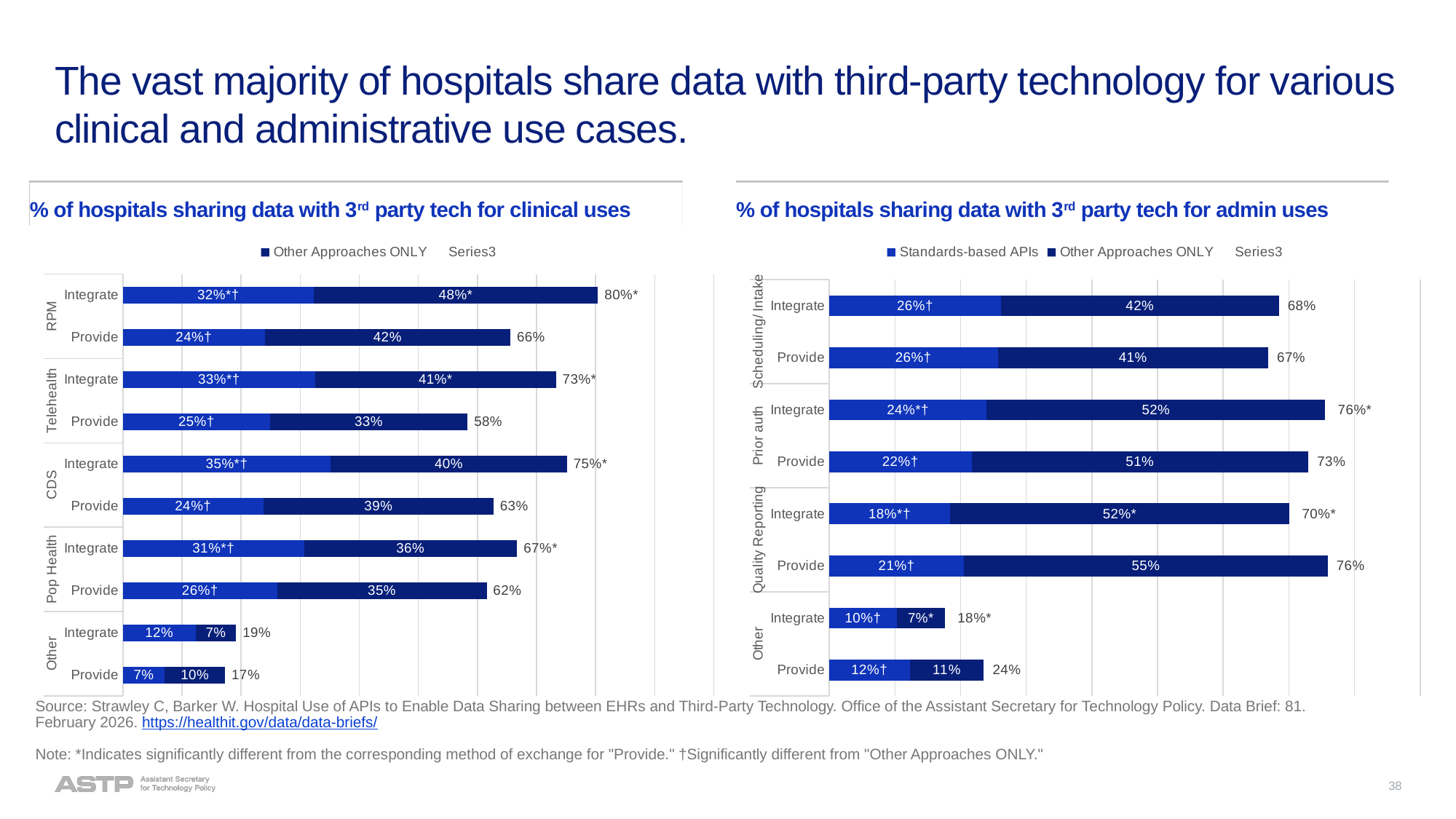
In the clinical uses chart, what is the total percentage labelled for RPM Integrate? 80%* How many bars are plotted in the admin uses chart? 8 In the admin uses chart, what is the Standards-based APIs value for Quality Reporting Provide? 21%† In the admin uses chart, what is the total percentage labelled for Prior auth Integrate? 76%* In the admin uses chart, which bar has the lowest total percentage? Other Integrate (18%*) In the clinical uses chart, which bar has the highest total percentage? RPM Integrate (80%*) How many series does the legend of the admin uses chart list? 3 In the clinical uses chart, what is the Other Approaches ONLY value for Telehealth Provide? 33% In the clinical uses chart, which bar has the lowest total percentage? Other Provide (17%) In the clinical uses chart, what is the difference between the CDS Integrate total (75%) and the CDS Provide total (63%)? 12 percentage points In the admin uses chart, which has the larger total: Quality Reporting Provide or Quality Reporting Integrate? Quality Reporting Provide (76%) What kind of chart is the '% of hospitals sharing data with 3rd party tech for clinical uses' chart? Stacked bar chart